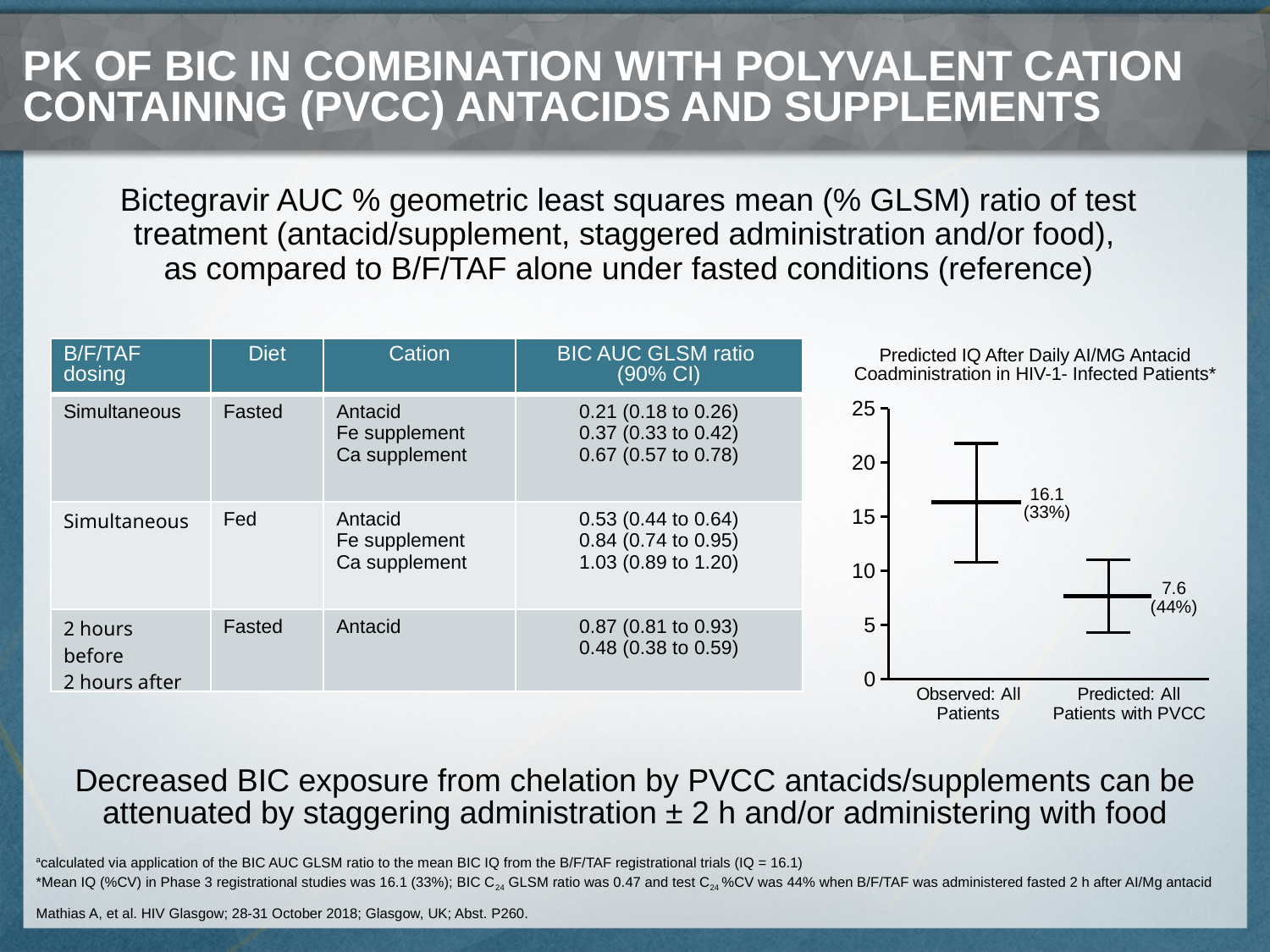
In the chart on the right, what is the value labelled for Observed: All Patients? 16.1 In the chart on the right, what percentage is shown in parentheses next to the Predicted: All Patients with PVCC value? 44% How many categories are shown on the x axis of the chart on the right? 2 In the chart on the right, what is the maximum value shown on the y axis? 25 In the chart on the right, what is the difference between the Observed: All Patients value and the Predicted: All Patients with PVCC value? 8.5 In the chart on the right, which category has the lower labelled value? Predicted: All Patients with PVCC In the chart on the right, is the value for Observed: All Patients greater or less than 15? greater What is the title of the chart on the right side of the slide? Predicted IQ After Daily Al/MG Antacid Coadministration in HIV-1- Infected Patients* In the chart on the right, which category has the higher labelled value? Observed: All Patients In the chart on the right, what percentage is shown in parentheses next to the Observed: All Patients value? 33% In the chart on the right, is the value for Predicted: All Patients with PVCC greater or less than 10? less In the chart on the right, what is the value labelled for Predicted: All Patients with PVCC? 7.6